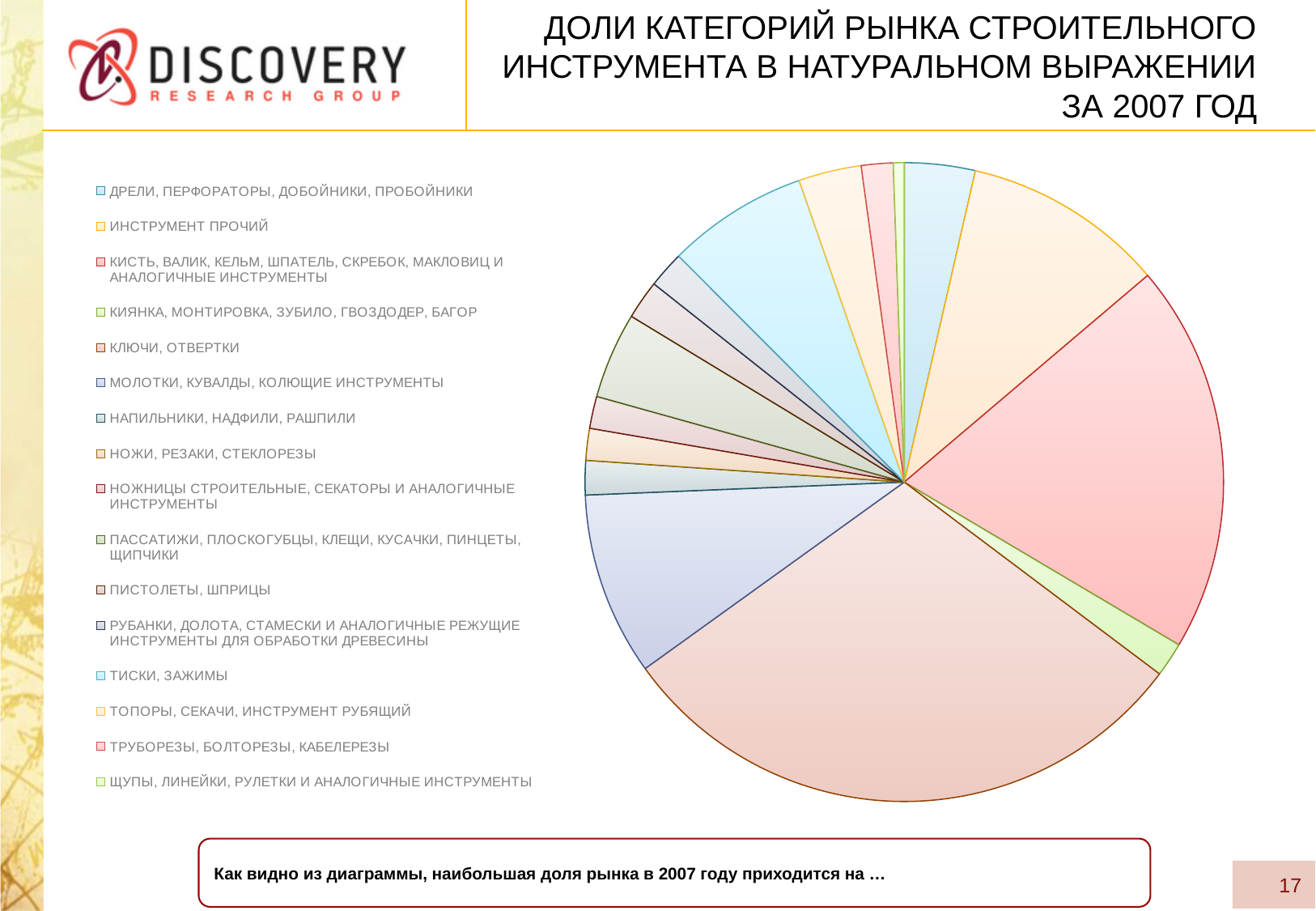
Which slice is larger: КИСТЬ, ВАЛИК, КЕЛЬМ, ШПАТЕЛЬ, СКРЕБОК, МАКЛОВИЦ И АНАЛОГИЧНЫЕ ИНСТРУМЕНТЫ or ДРЕЛИ, ПЕРФОРАТОРЫ, ДОБОЙНИКИ, ПРОБОЙНИКИ? КИСТЬ, ВАЛИК, КЕЛЬМ, ШПАТЕЛЬ, СКРЕБОК, МАКЛОВИЦ И АНАЛОГИЧНЫЕ ИНСТРУМЕНТЫ What kind of chart is shown on the slide? Pie chart Which year does the pie chart's title refer to? 2007 Which category has the largest slice of the pie chart? КЛЮЧИ, ОТВЕРТКИ What is the title of the pie chart on the slide? ДОЛИ КАТЕГОРИЙ РЫНКА СТРОИТЕЛЬНОГО ИНСТРУМЕНТА В НАТУРАЛЬНОМ ВЫРАЖЕНИИ ЗА 2007 ГОД How many categories does the pie chart's legend list? 16 Which slice is larger: МОЛОТКИ, КУВАЛДЫ, КОЛЮЩИЕ ИНСТРУМЕНТЫ or КИЯНКА, МОНТИРОВКА, ЗУБИЛО, ГВОЗДОДЕР, БАГОР? МОЛОТКИ, КУВАЛДЫ, КОЛЮЩИЕ ИНСТРУМЕНТЫ Which slice is larger: КЛЮЧИ, ОТВЕРТКИ or ИНСТРУМЕНТ ПРОЧИЙ? КЛЮЧИ, ОТВЕРТКИ